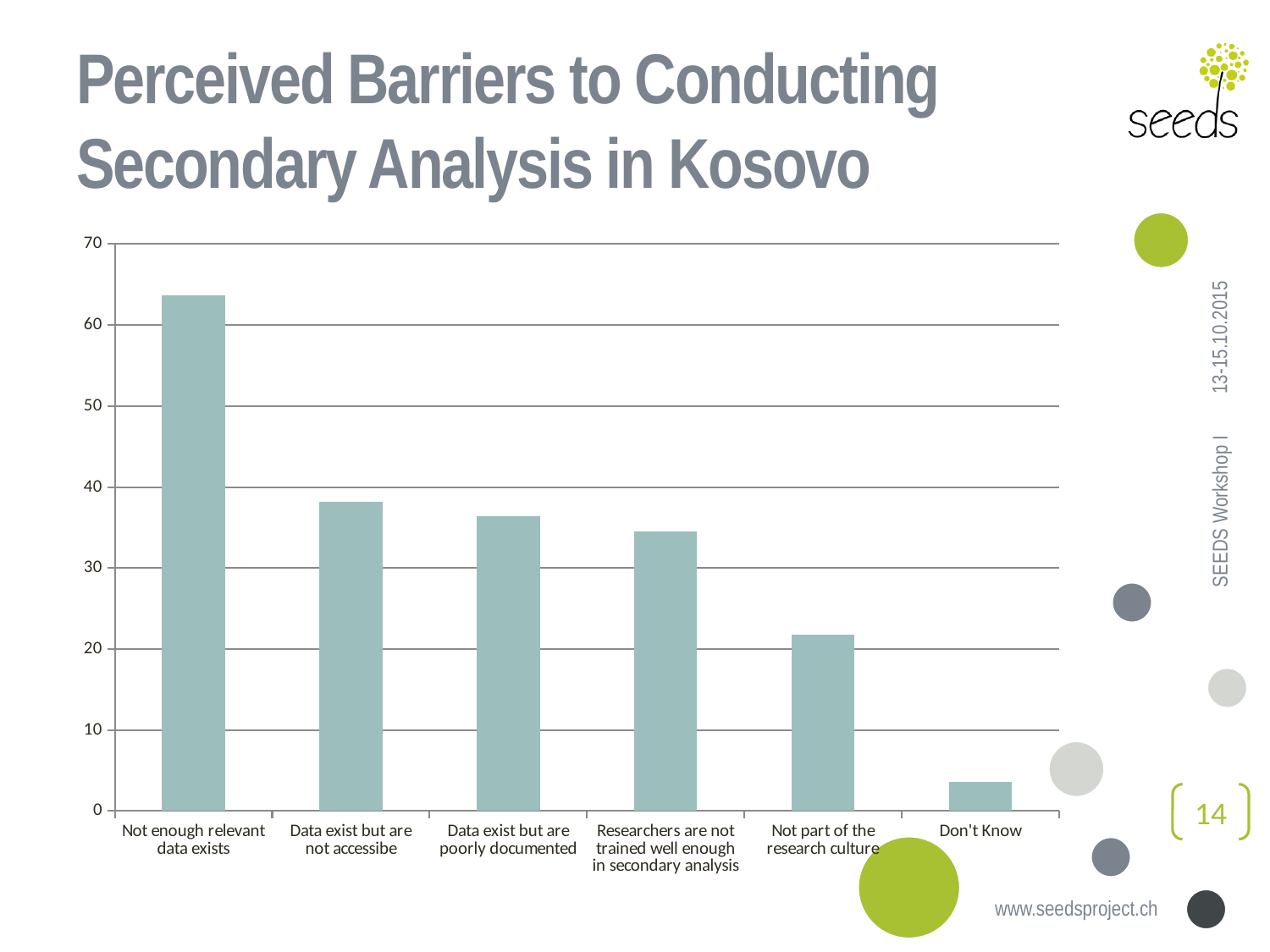
Which category has the lowest value? Don't Know Is the value for "Not part of the research culture" greater or less than 20? greater Is the value for "Not enough relevant data exists" greater or less than 60? greater What kind of chart is shown on the slide? bar chart Is the value for "Researchers are not trained well enough in secondary analysis" greater or less than 30? greater Which barrier has the highest value? Not enough relevant data exists Do the bar values rise or fall from left to right across the chart? fall How many categories (barriers) are plotted on the chart? 6 What is the title of the slide containing the chart? Perceived Barriers to Conducting Secondary Analysis in Kosovo Which is larger: the value for "Researchers are not trained well enough in secondary analysis" or for "Not part of the research culture"? Researchers are not trained well enough in secondary analysis